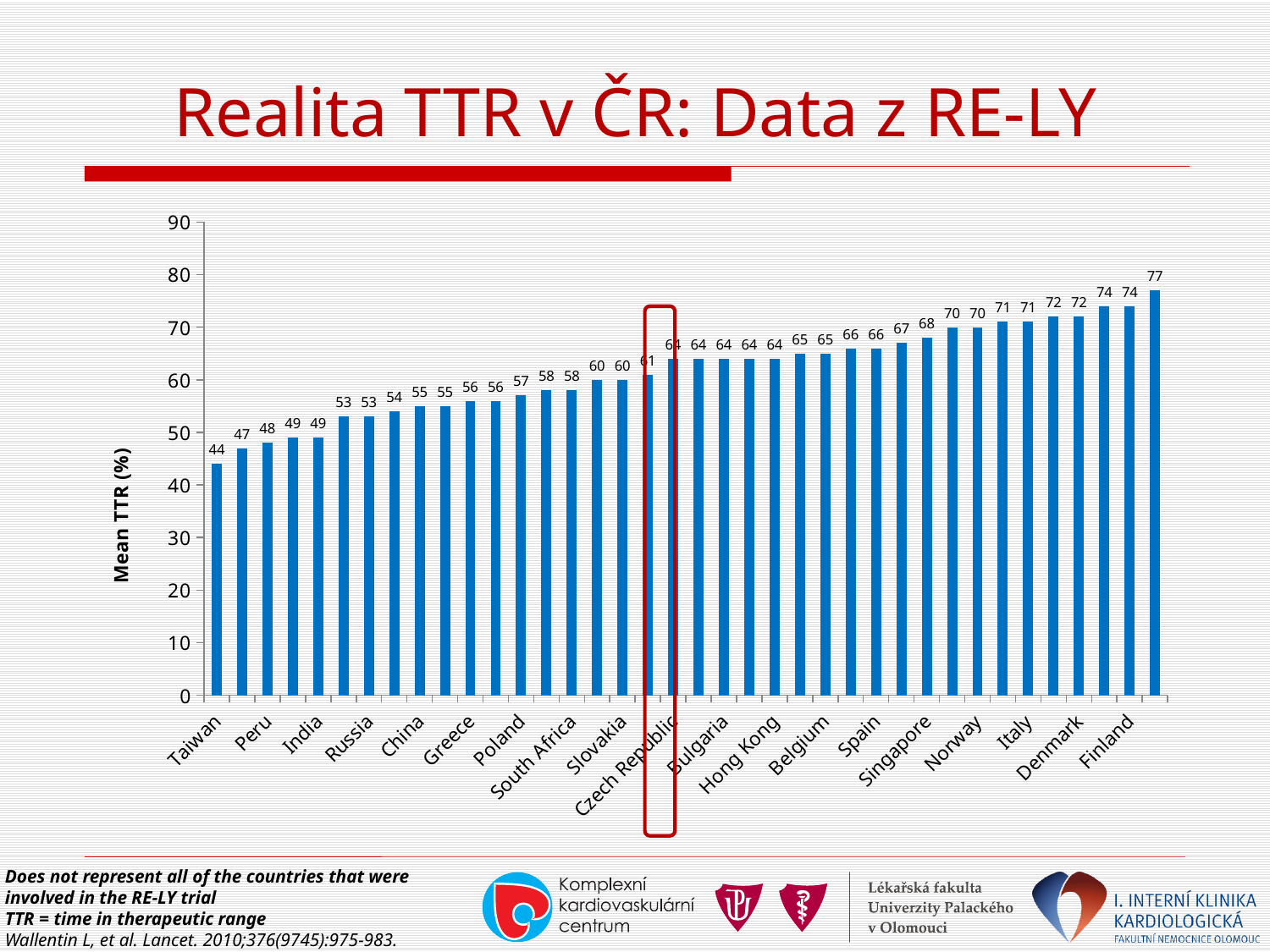
What is the Mean TTR (%) value for Taiwan? 44 What is the difference between the highest and lowest Mean TTR (%) values in the chart? 33 Do the Mean TTR (%) values rise or fall from left to right across the chart? rise Which country's bar is highlighted with a red box in the chart? Czech Republic Is the Mean TTR (%) value for the Czech Republic greater or less than 60? greater What is the label of the vertical axis of the chart? Mean TTR (%) What is the Mean TTR (%) value for the Czech Republic, the bar highlighted with the red box? 64 How much higher is the Mean TTR (%) for the Czech Republic than for Taiwan? 20 Which has the larger Mean TTR (%), Taiwan or the Czech Republic? Czech Republic What is the lowest Mean TTR (%) value shown in the chart? 44 What kind of chart is shown on the slide? bar chart What is the highest Mean TTR (%) value shown in the chart? 77